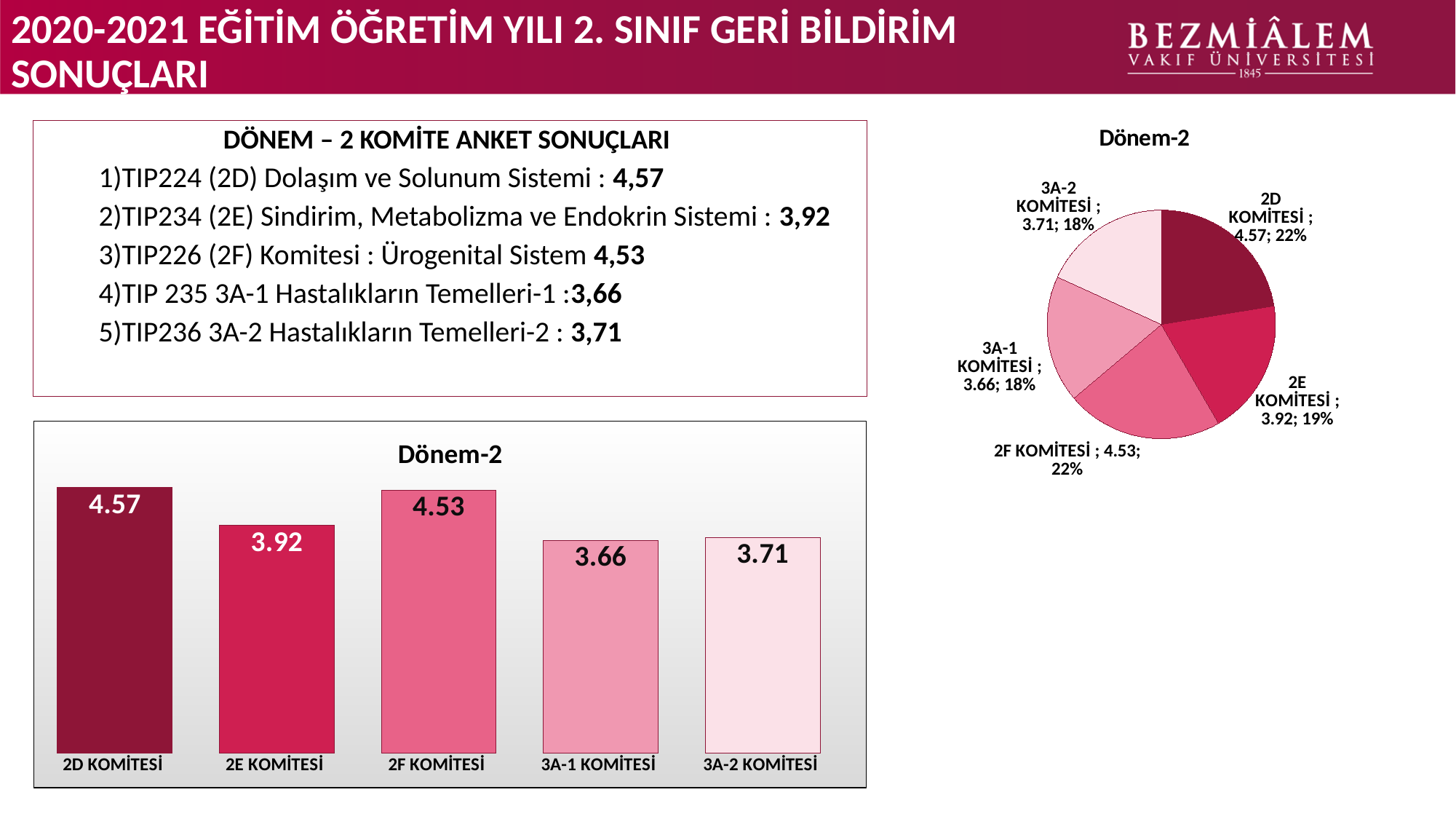
In the bar chart at the bottom left of the slide, what is the difference between the values for 2D KOMİTESİ and 2E KOMİTESİ? 0.65 In the bar chart at the bottom left of the slide, which category has the lowest value? 3A-1 KOMİTESİ What is the title of the pie chart on the right of the slide? Dönem-2 In the bar chart at the bottom left of the slide, which category has the highest value? 2D KOMİTESİ How many slices does the pie chart on the right of the slide have? 5 In the pie chart on the right of the slide, what value is shown for 3A-2 KOMİTESİ? 3.71 In the bar chart at the bottom left of the slide, which is larger: the value for 2F KOMİTESİ or the value for 3A-2 KOMİTESİ? 2F KOMİTESİ In the bar chart at the bottom left of the slide, what is the value for 2D KOMİTESİ? 4.57 In the pie chart on the right of the slide, what percentage share does 2E KOMİTESİ have? 19% How many bars are in the bar chart at the bottom left of the slide? 5 In the bar chart at the bottom left of the slide, what is the value for 3A-1 KOMİTESİ? 3.66 What kind of chart is shown at the bottom left of the slide? Bar chart